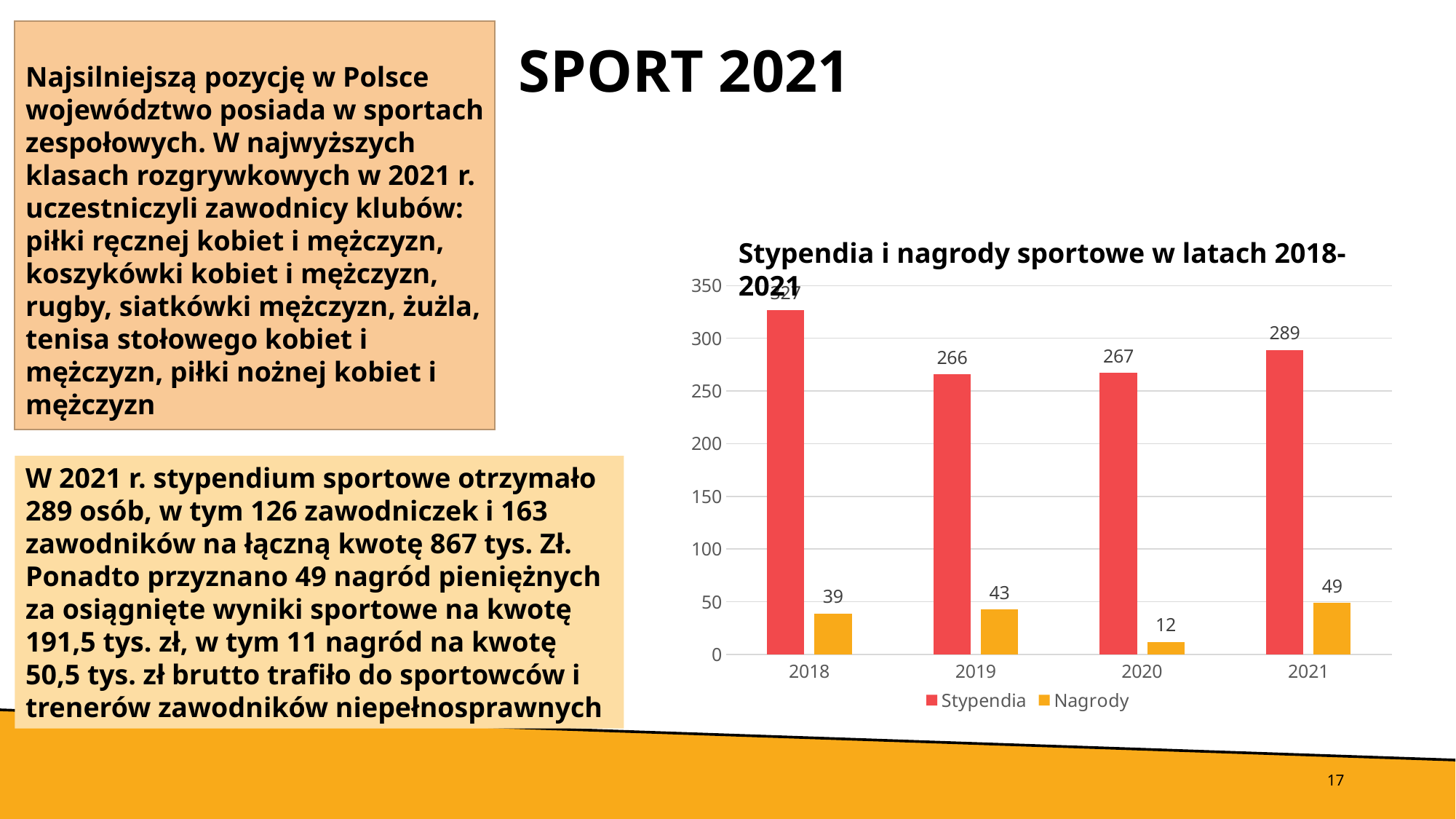
What is the difference between Stypendia and Nagrody in 2021? 240 By how much did Stypendia increase from 2020 to 2021? 22 How many series does the legend list? 2 What type of chart is shown on the slide? bar chart What is the value for Nagrody in 2020? 12 In which year is the Stypendia value highest? 2018 What is the value for Stypendia in 2021? 289 What is the value for Nagrody in 2018? 39 Is the value for Stypendia in 2018 greater or less than 300? greater What is the value for Stypendia in 2019? 266 In which year is the Nagrody value lowest? 2020 In which year is the Nagrody value highest? 2021